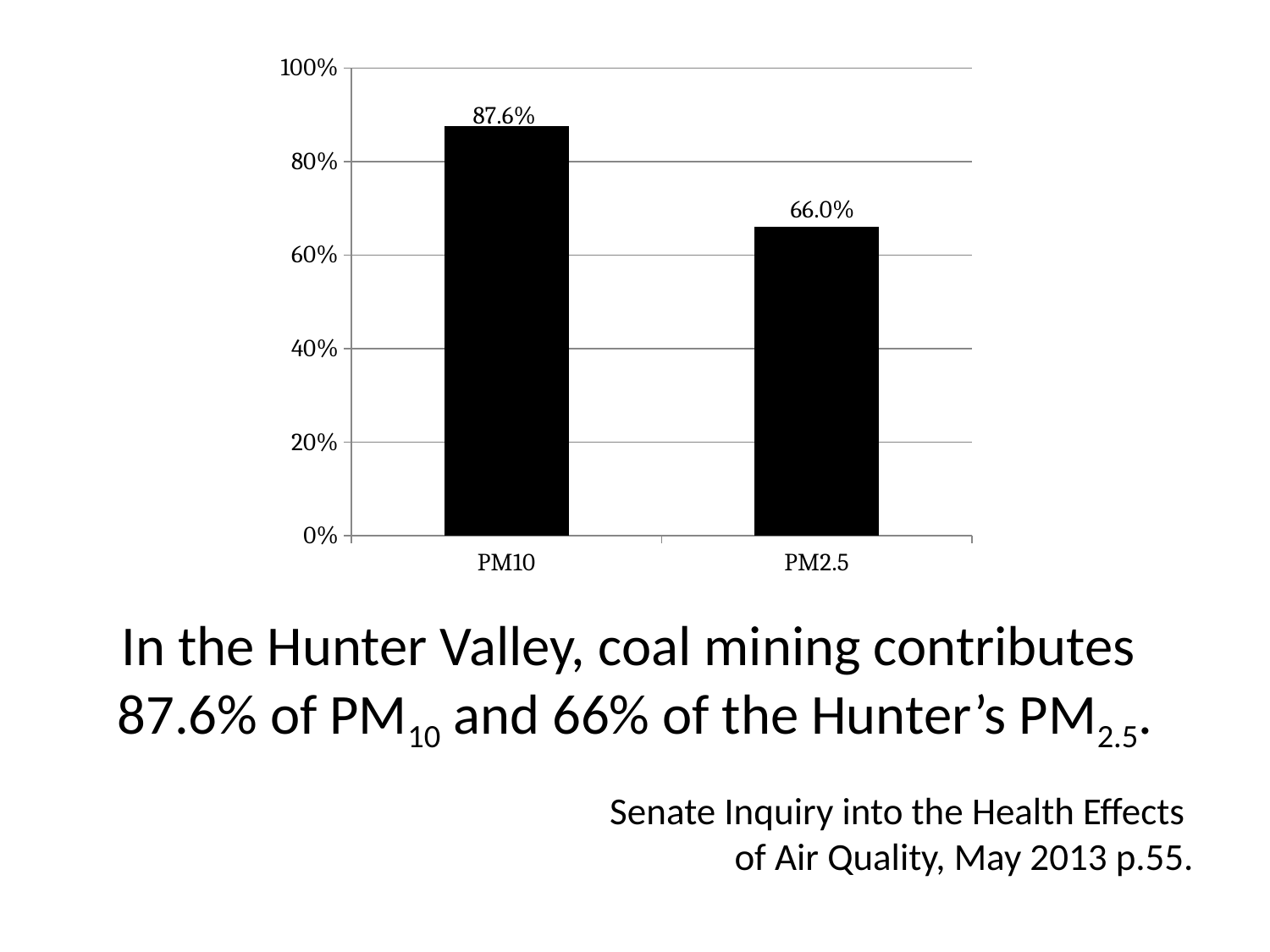
Which is larger, the value for PM10 or the value for PM2.5? PM10 Is the value for PM10 greater or less than 80%? greater How many categories are shown on the x axis? 2 What kind of chart is shown on the slide? bar chart What is the value for PM10? 87.6% What is the difference between the values for PM10 and PM2.5? 21.6% What is the value for PM2.5? 66.0% What is the highest value shown on the y axis? 100% What colour are the bars in the chart? black Which category has the lowest value? PM2.5 Which category has the highest value? PM10 Is the value for PM2.5 greater or less than 80%? less